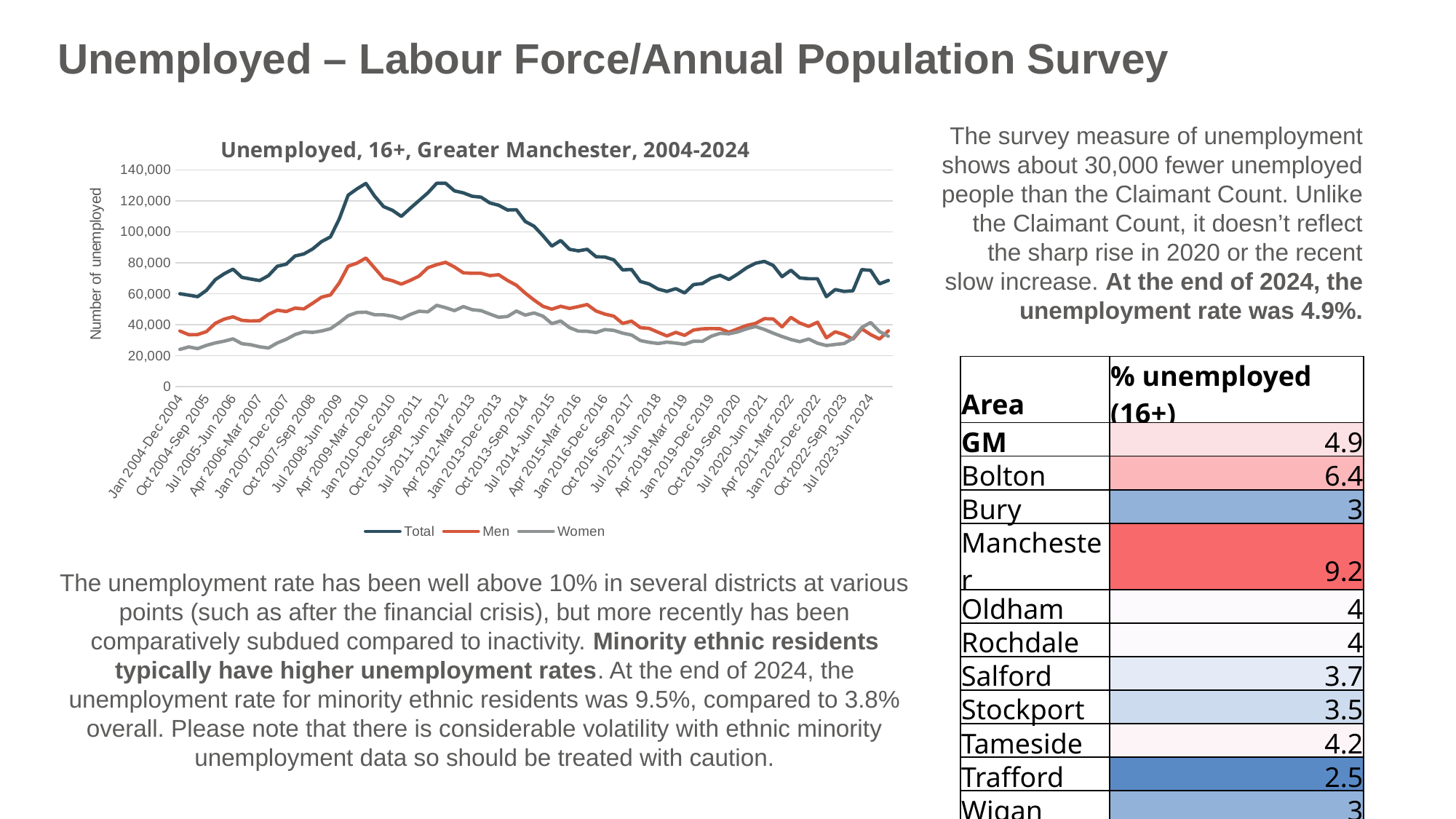
Is the value of the Men series at Apr 2009-Mar 2010 greater or less than 60,000? greater What is the label on the vertical axis of the chart? Number of unemployed Is the value of the Women series at Jan 2004-Dec 2004 greater or less than 40,000? less What is the title of the chart? Unemployed, 16+, Greater Manchester, 2004-2024 Does the Total series rise or fall between Jan 2004-Dec 2004 and Apr 2009-Mar 2010? rise Is the peak value of the Total series greater or less than 140,000? less What type of chart is shown on the slide? line chart Which series has the highest values throughout the chart? Total At Apr 2009-Mar 2010, which series is larger, Men or Women? Men How many series does the legend of the chart list? 3 Does the Total series rise or fall between Apr 2012-Mar 2013 and Jan 2019-Dec 2019? fall